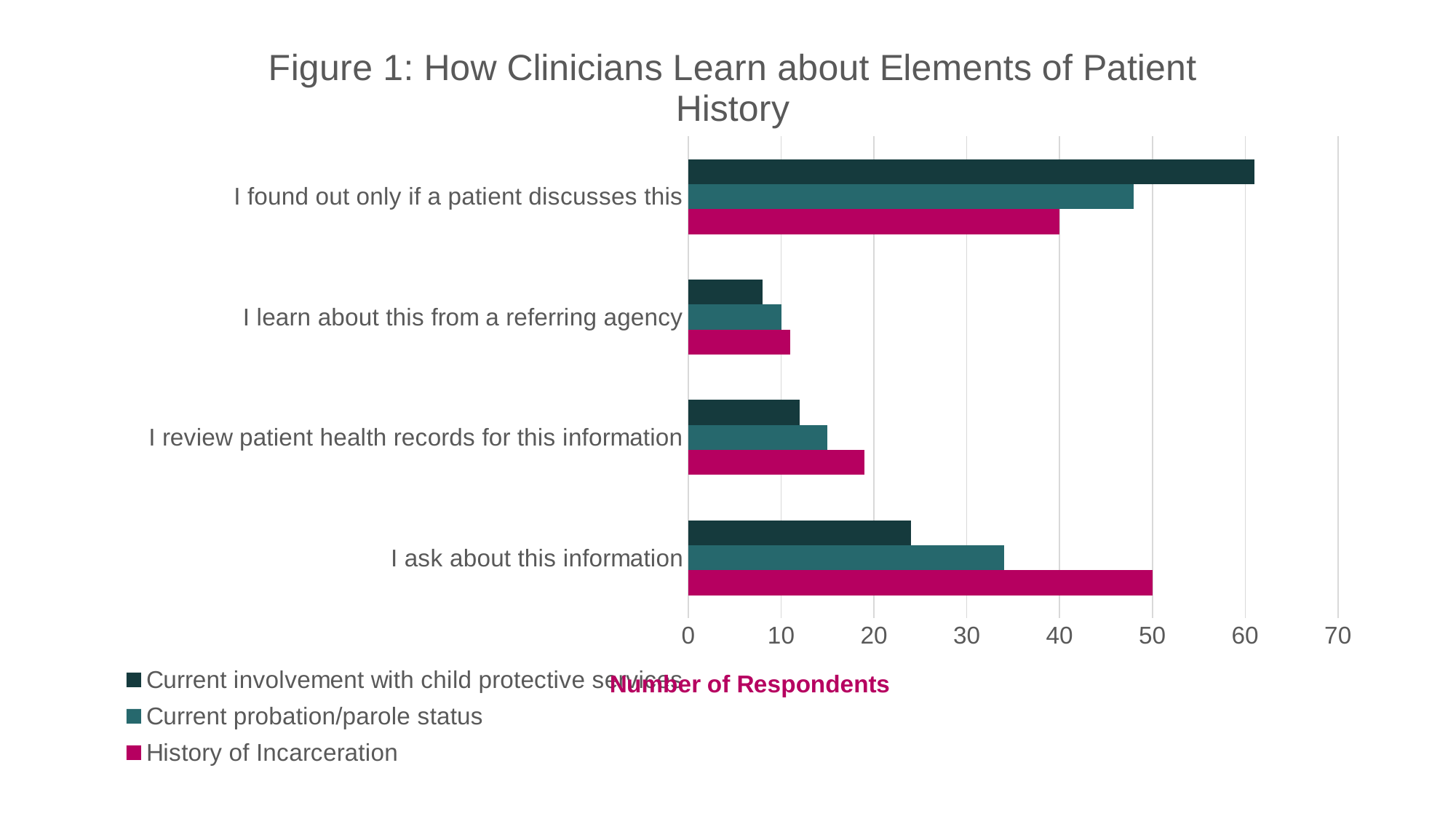
What is the value for History of Incarceration in the category "I ask about this information"? 50 What kind of chart is shown on the slide? bar chart How many categories are shown on the vertical axis? 4 What is the title of the chart? Figure 1: How Clinicians Learn about Elements of Patient History Is the value for Current probation/parole status in "I review patient health records for this information" greater or less than 20? less How many series does the legend list? 3 What is the label of the horizontal axis? Number of Respondents What is the value for History of Incarceration in the category "I found out only if a patient discusses this"? 40 Which category has the highest value for Current involvement with child protective services? I found out only if a patient discusses this Which category has the lowest value for History of Incarceration? I learn about this from a referring agency In the category "I ask about this information", which series has the larger value: Current probation/parole status or Current involvement with child protective services? Current probation/parole status